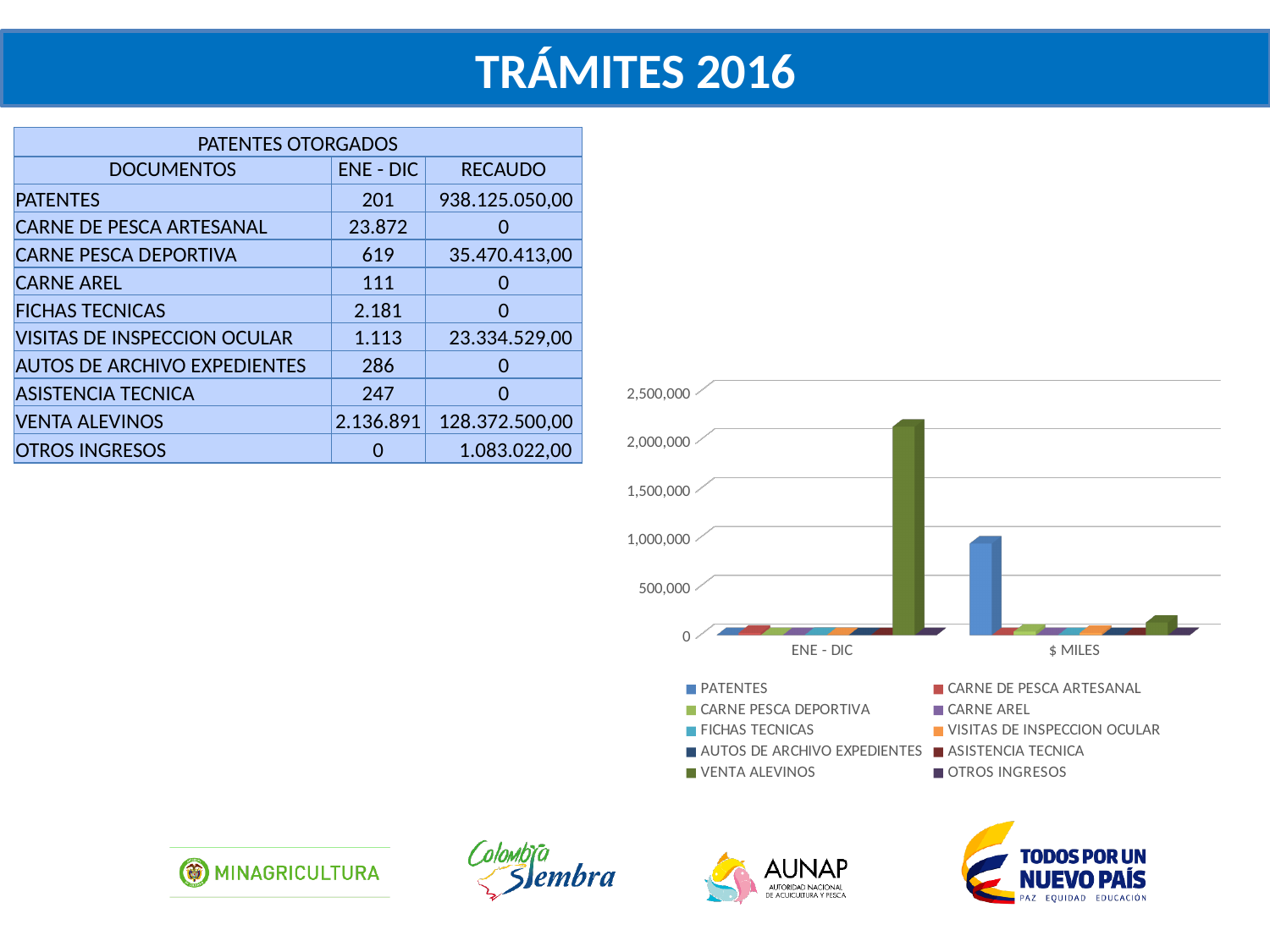
Is the value for VENTA ALEVINOS in the ENE - DIC category greater or less than 2,000,000? greater What are the two category labels on the x axis of the chart? ENE - DIC and $ MILES Is the value for VENTA ALEVINOS in the $ MILES category greater or less than 500,000? less How many series does the chart's legend list? 10 What kind of chart is shown on the slide? bar chart Which series has the tallest bar in the $ MILES category? PATENTES What colour represents the VENTA ALEVINOS series in the chart? green Which series has the tallest bar in the ENE - DIC category? VENTA ALEVINOS Which is larger: the VENTA ALEVINOS bar in ENE - DIC or the PATENTES bar in $ MILES? VENTA ALEVINOS in ENE - DIC How many categories are shown along the x axis of the chart? 2 Is the value for PATENTES in the $ MILES category greater or less than 1,000,000? less